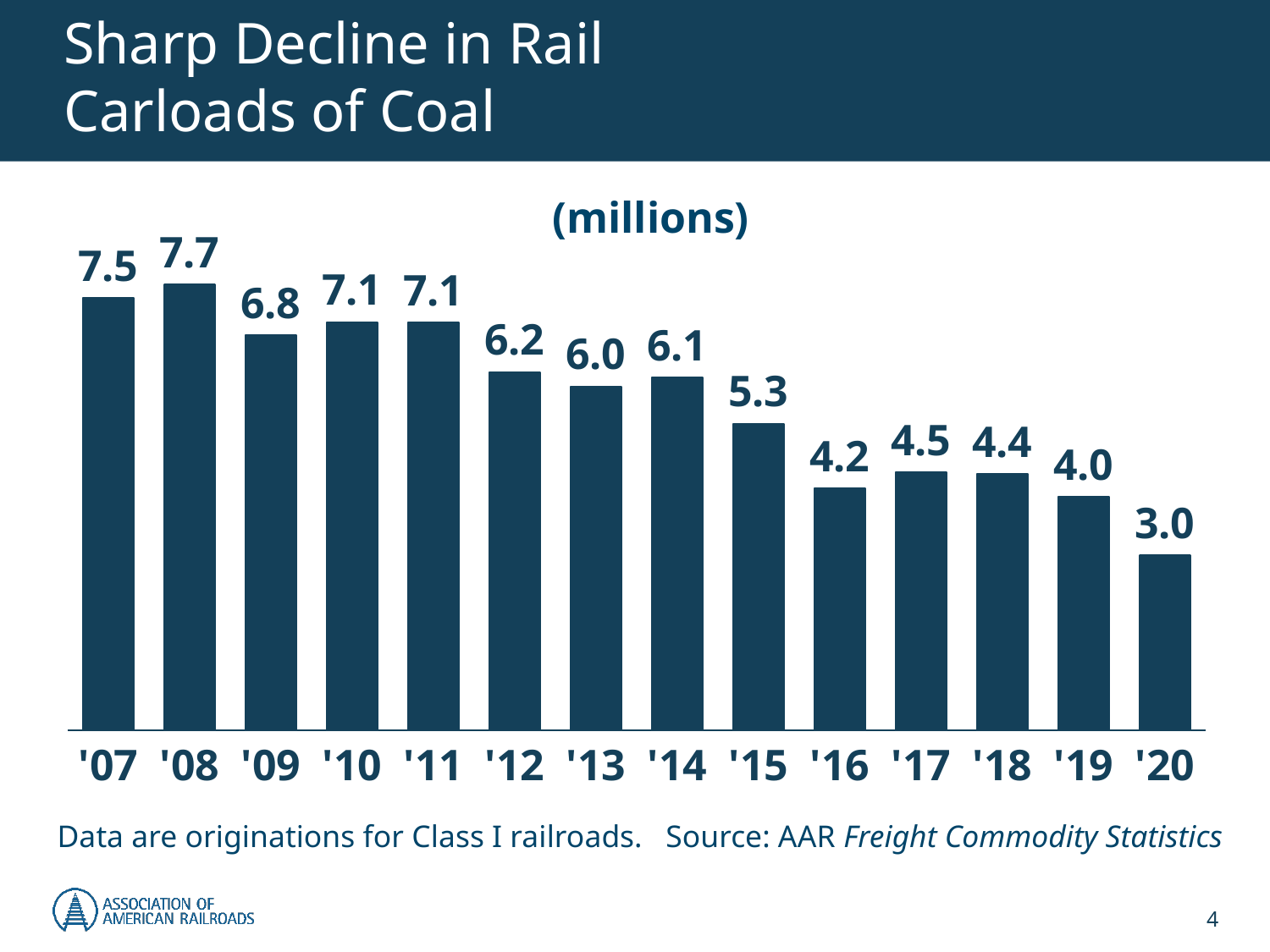
Which year has the highest value? '08 Which is larger, the value for '09 or the value for '12? '09 What unit label is shown above the chart? (millions) Do the values generally rise or fall from '07 to '20? fall How many years are shown on the x axis? 14 What kind of chart is this? bar chart What is the difference between the values for '07 and '20? 4.5 What is the value for '08? 7.7 Which year has the lowest value? '20 What is the difference between the values for '17 and '18? 0.1 What is the value for '20? 3.0 What is the value for '15? 5.3